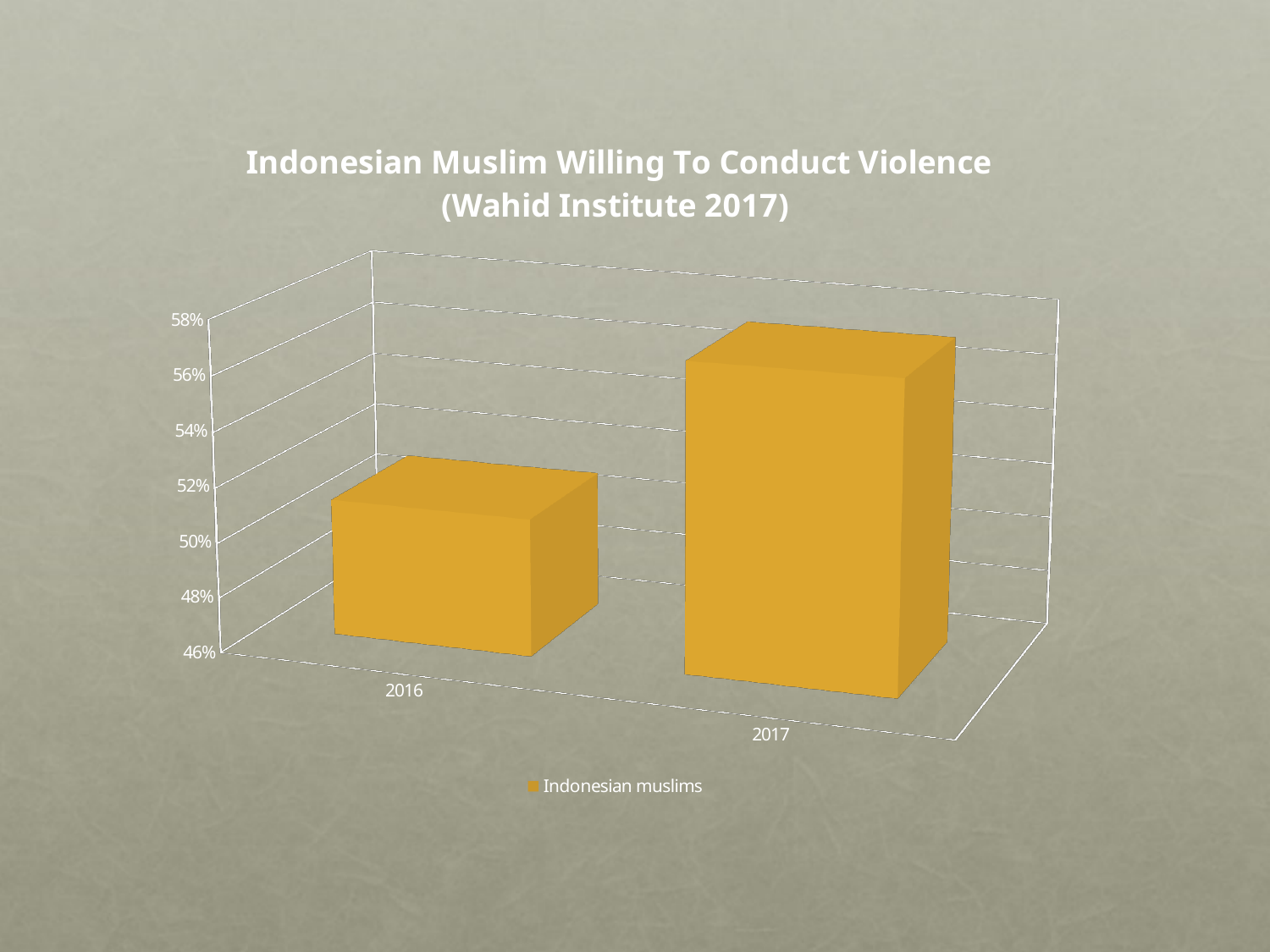
Which year has the lowest value? 2016 Is the value for 2017 greater or less than 52%? greater Do the values rise or fall from 2016 to 2017? rise What series name is shown in the legend? Indonesian muslims Is the value for 2016 greater or less than 48%? greater Which year has the highest value? 2017 How many categories (years) are plotted on the chart? 2 How many series does the legend list? 1 Which is larger, the value for 2016 or the value for 2017? 2017 Is the value for 2016 greater or less than 54%? less What is the title of the chart? Indonesian Muslim Willing To Conduct Violence (Wahid Institute 2017) What kind of chart is shown on the slide? bar chart